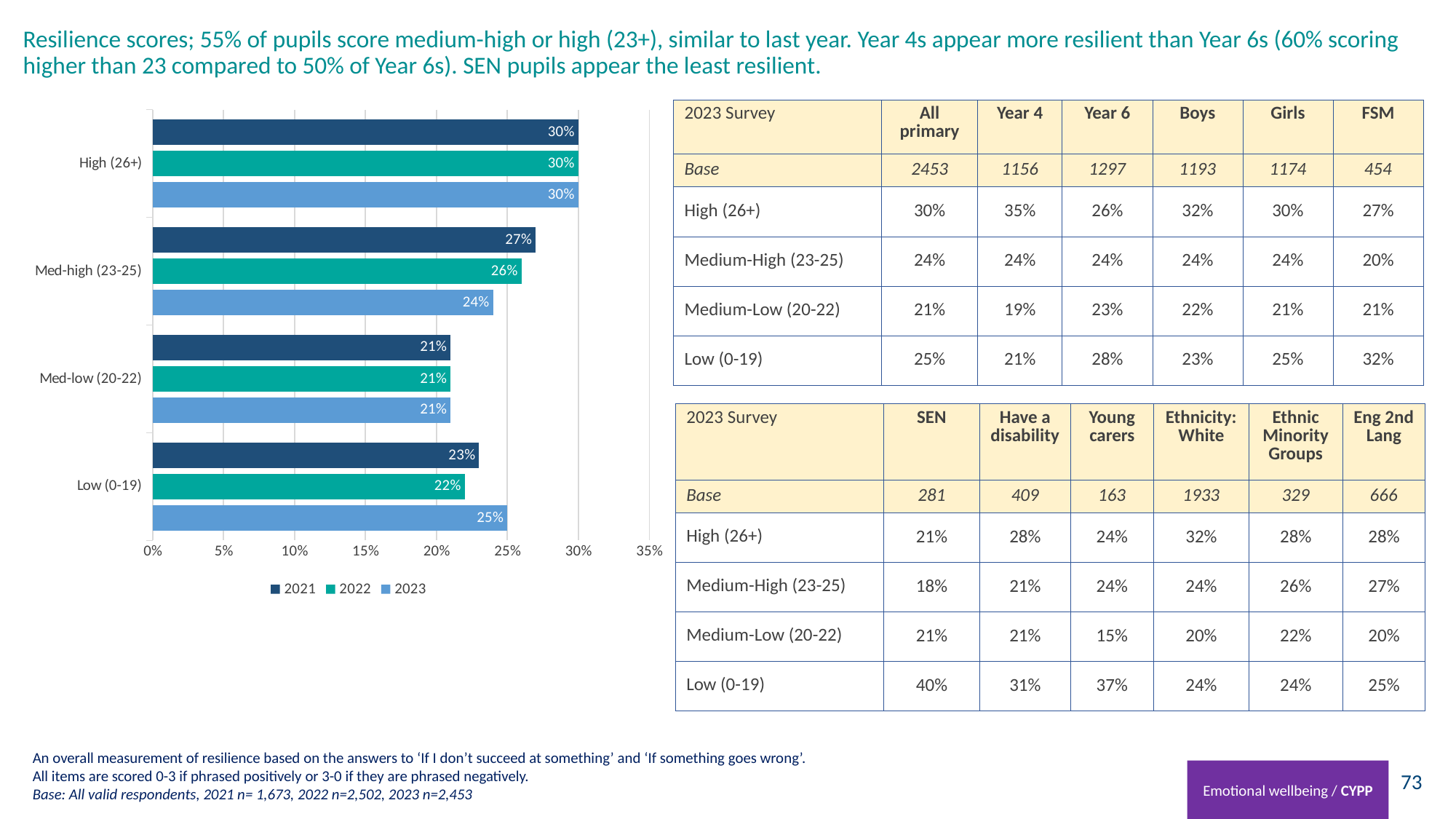
Which is larger for Low (0-19): the 2022 value or the 2023 value? 2023 How many categories are shown on the chart? 4 What are the series names listed in the legend? 2021, 2022, 2023 What is the difference between the 2021 and 2023 values for Med-high (23-25)? 3% Is the 2021 value for Med-high (23-25) greater or less than 25%? greater Which category has the highest 2023 value? High (26+) What is the 2021 value for Low (0-19)? 23% What is the 2023 value for Med-high (23-25)? 24% What kind of chart is shown on the slide? bar chart How many series does the legend list? 3 Which category has the lowest 2021 value? Med-low (20-22) What is the 2022 value for Med-high (23-25)? 26%